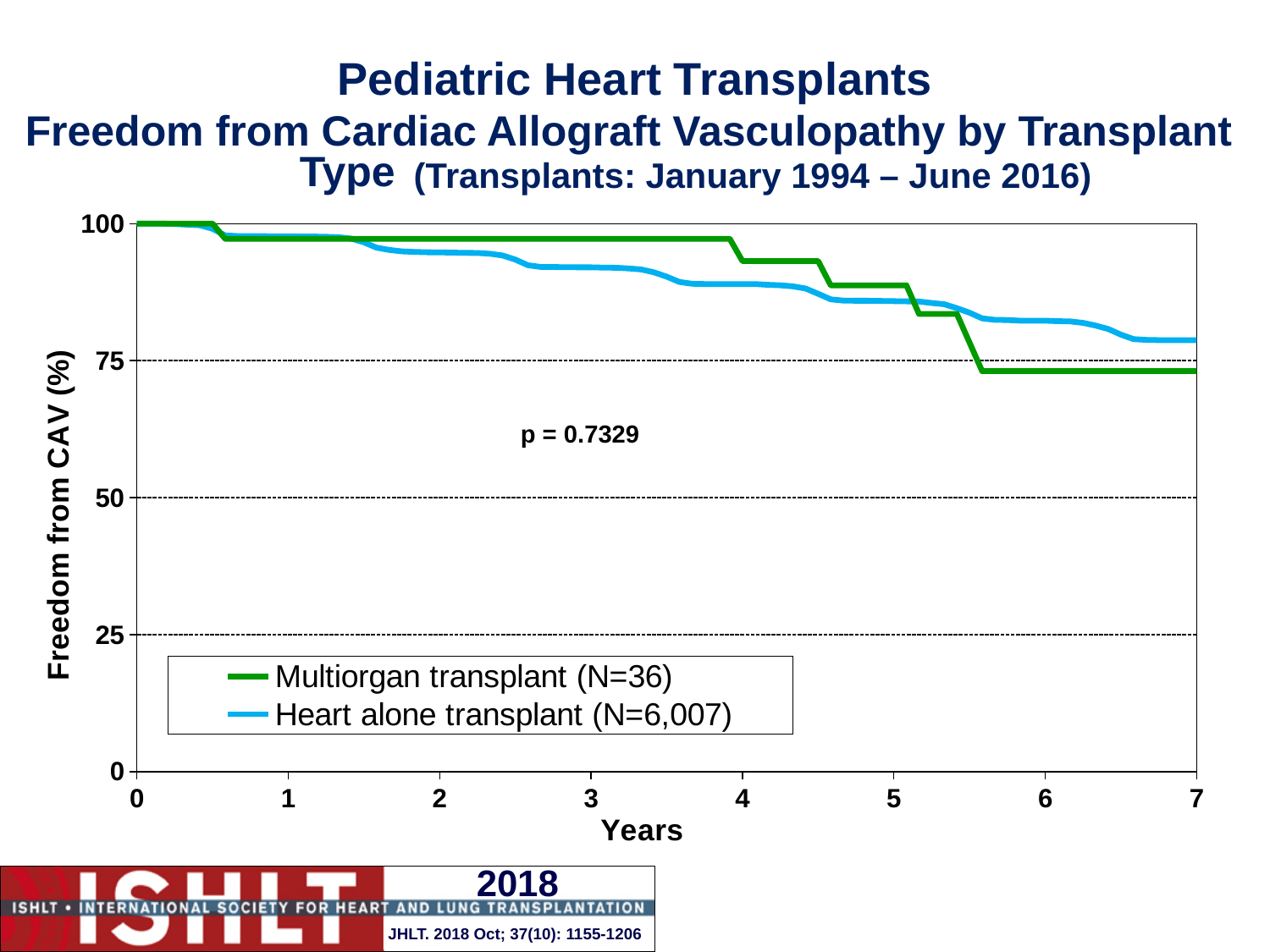
Is the value for Heart alone transplant at year 7 greater or less than 75? greater Is the value for Multiorgan transplant at year 5 greater or less than 75? greater What kind of chart is shown on the slide? line chart Is the value for Multiorgan transplant at year 7 greater or less than 75? less What is the N shown in the legend for Multiorgan transplant? N=36 At year 7, which series has the higher freedom from CAV: Multiorgan transplant or Heart alone transplant? Heart alone transplant Do the values for Heart alone transplant rise or fall as years increase? fall Do the values for Multiorgan transplant rise or fall as years increase? fall What p-value is printed on the chart? p = 0.7329 At year 3, which series has the higher freedom from CAV: Multiorgan transplant or Heart alone transplant? Multiorgan transplant How many series does the legend list? 2